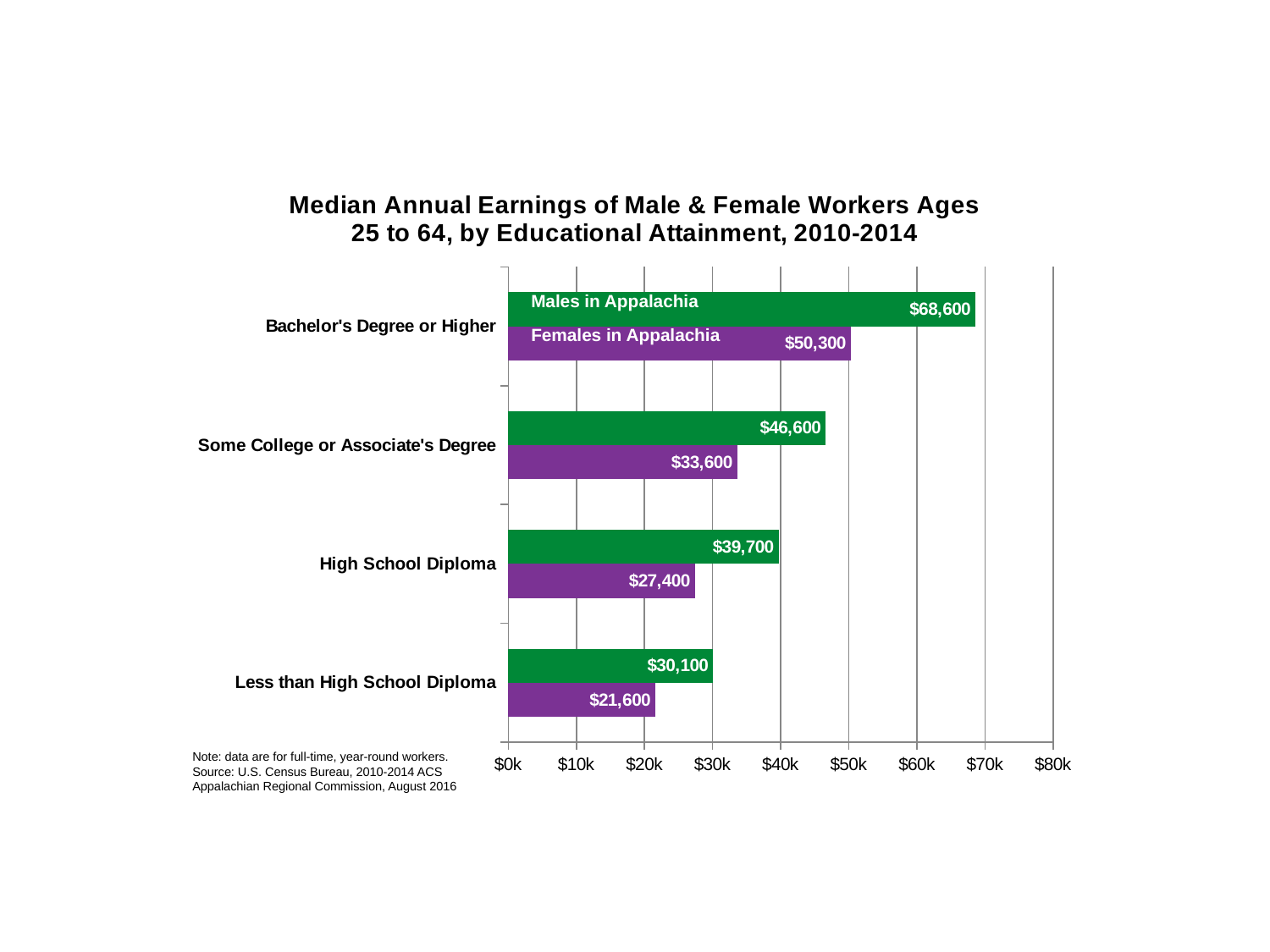
Which is larger: median earnings of females with a Bachelor's Degree or Higher, or males with Some College or Associate's Degree? Females with a Bachelor's Degree or Higher What are the median annual earnings of females in Appalachia with a High School Diploma? $27,400 What are the median annual earnings of males in Appalachia with a Bachelor's Degree or Higher? $68,600 What type of chart is shown on the slide? Bar chart What is the difference between male and female median annual earnings for workers with Less than High School Diploma? $8,500 What colour are the bars for Females in Appalachia? Purple How many data series does the chart show? 2 Which educational attainment category has the lowest median annual earnings for females in Appalachia? Less than High School Diploma What is the difference between male and female median annual earnings for workers with a Bachelor's Degree or Higher? $18,300 What are the median annual earnings of females in Appalachia with Some College or Associate's Degree? $33,600 Which educational attainment category has the highest median annual earnings for males in Appalachia? Bachelor's Degree or Higher How many educational attainment categories are shown on the chart? 4